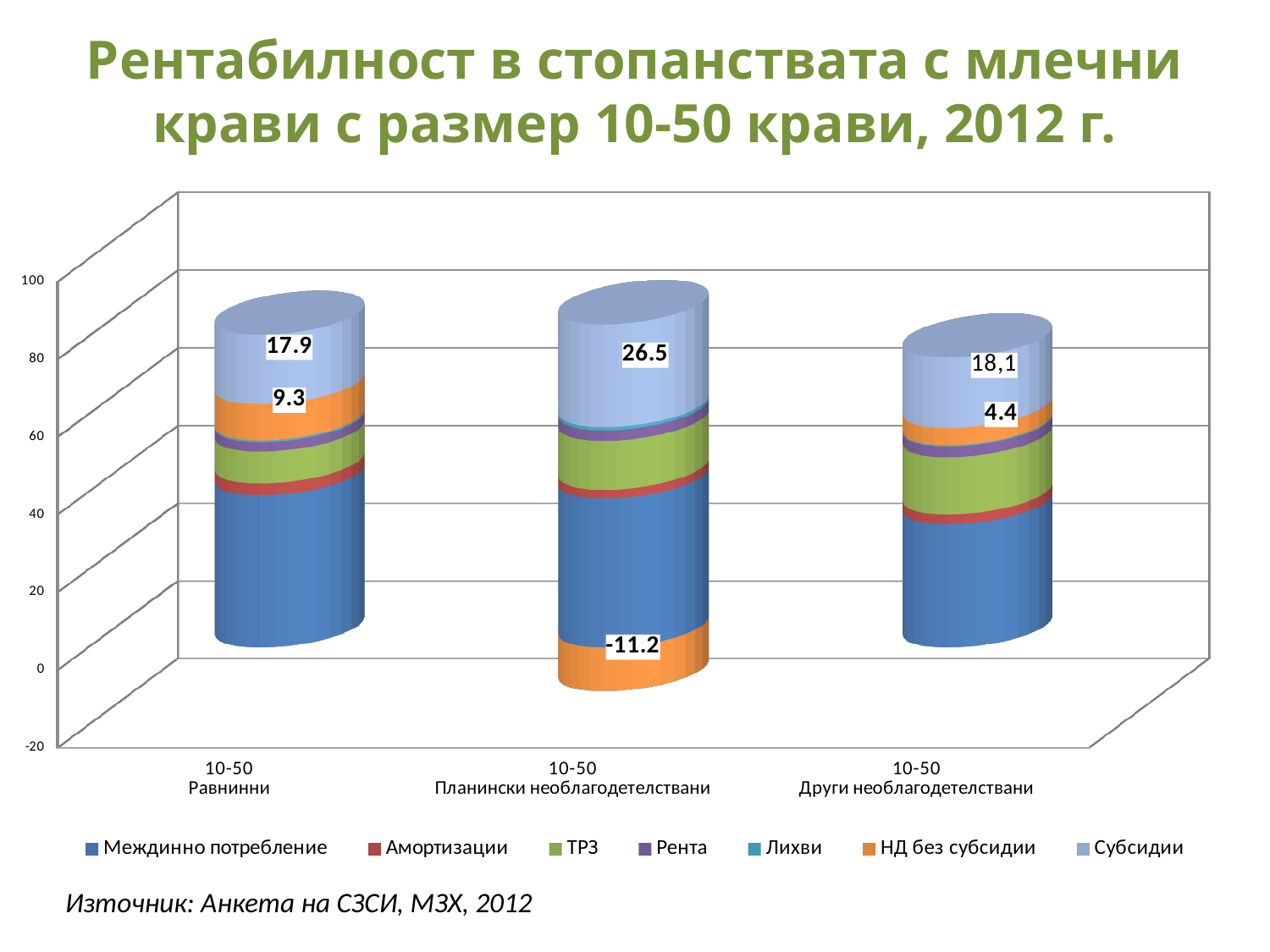
What is the value of Субсидии for the 10-50 Други необлагодетелствани category? 18,1 What is the value of НД без субсидии for the 10-50 Други необлагодетелствани category? 4.4 What is the value of Субсидии for the 10-50 Равнинни category? 17.9 What kind of chart is shown on the slide? Stacked bar chart How many series does the legend list? 7 What is the value of НД без субсидии for the 10-50 Планински необлагодетелствани category? -11.2 Which category has the lowest value of НД без субсидии? 10-50 Планински необлагодетелствани Is the value of Междинно потребление for 10-50 Равнинни greater or less than 20? greater Which category has the highest value of Субсидии? 10-50 Планински необлагодетелствани What is the difference between the Субсидии values for 10-50 Планински необлагодетелствани and 10-50 Равнинни? 8.6 What is the value of Субсидии for the 10-50 Планински необлагодетелствани category? 26.5 Which is larger: НД без субсидии for 10-50 Равнинни or for 10-50 Други необлагодетелствани? 10-50 Равнинни